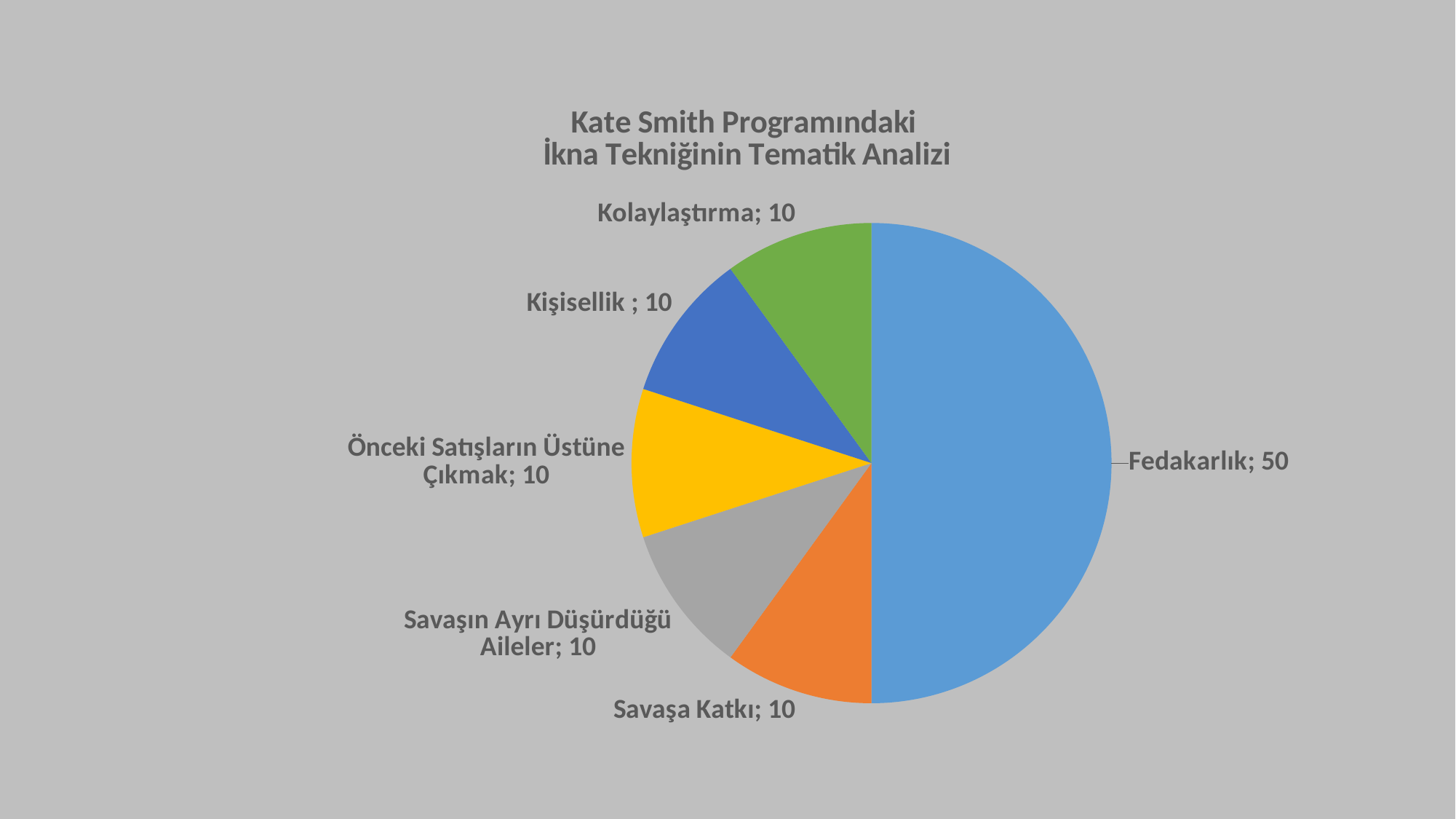
What share of the pie does Fedakarlık represent? 50% What is the difference between the values for Fedakarlık and Kişisellik? 40 Which category has the largest slice? Fedakarlık What is the value for Fedakarlık? 50 How many slices does the pie chart have? 6 What is the value for Önceki Satışların Üstüne Çıkmak? 10 What is the value for Kolaylaştırma? 10 Which is larger, the value for Fedakarlık or the value for Savaşın Ayrı Düşürdüğü Aileler? Fedakarlık What kind of chart is shown on the slide? pie chart What is the title of the chart? Kate Smith Programındaki İkna Tekniğinin Tematik Analizi What colour is the Fedakarlık slice? blue What is the value for Savaşa Katkı? 10